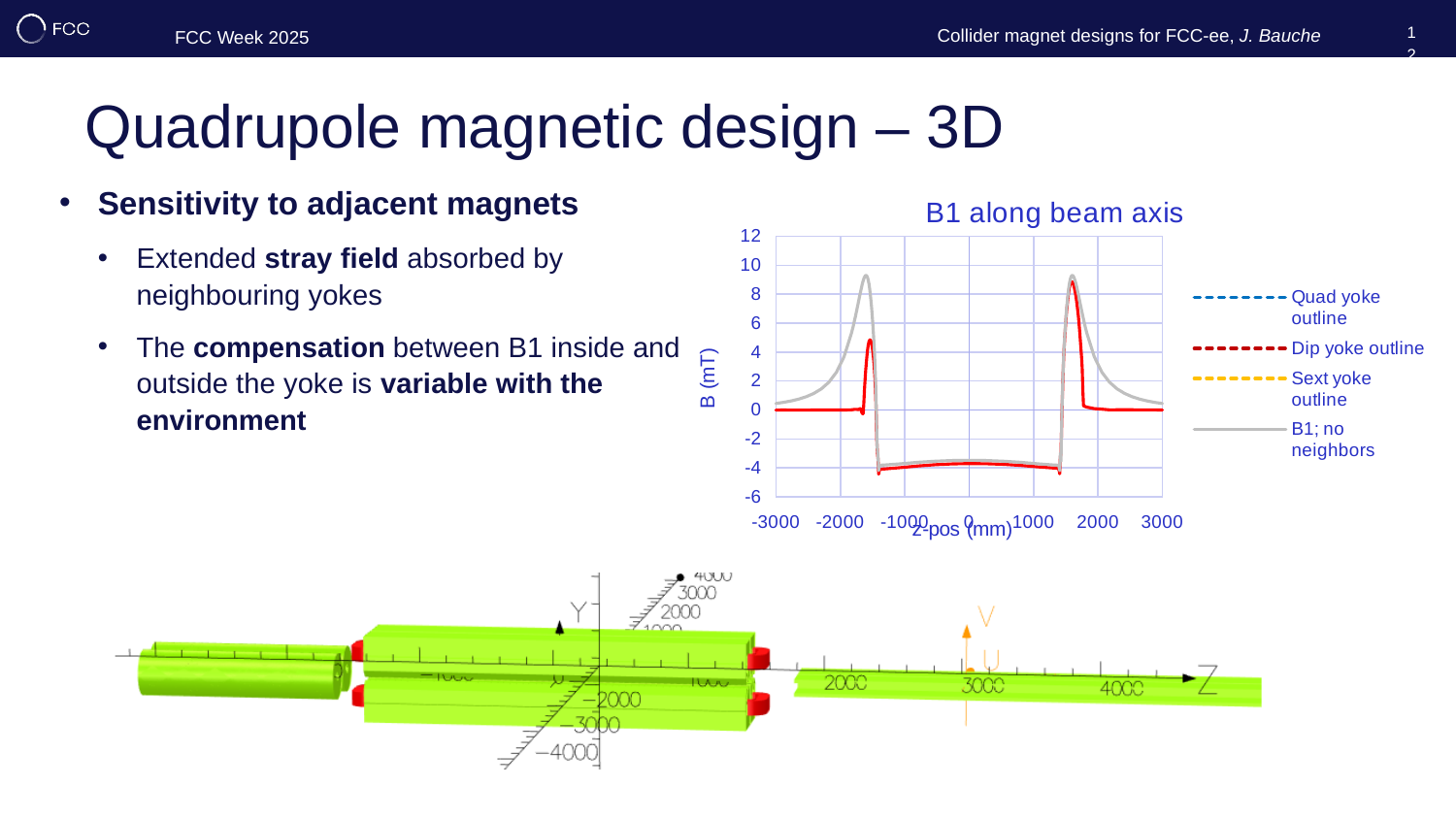
What is the highest value shown on the vertical axis of the "B1 along beam axis" chart? 12 What is the lowest value shown on the vertical axis of the "B1 along beam axis" chart? -6 In the "B1 along beam axis" chart, is the value of the "B1; no neighbors" line at z = 0 mm greater or less than -2 mT? less In the "B1 along beam axis" chart, is the value of the "B1; no neighbors" line at z = -3000 mm greater or less than 2 mT? less In the "B1 along beam axis" chart, is the peak of the red line near z = +1500 mm greater or less than 6 mT? greater What is the label of the vertical axis of the "B1 along beam axis" chart? B (mT) How many entries does the legend of the "B1 along beam axis" chart list? 4 In the "B1 along beam axis" chart, which peak of the red line is higher: the one near z = -1500 mm or the one near z = +1500 mm? the one near z = +1500 mm What is the title of the chart on the slide? B1 along beam axis What kind of chart is "B1 along beam axis"? line chart In the "B1 along beam axis" chart, which is higher near z = -1500 mm: the peak of the grey "B1; no neighbors" line or the peak of the red line? the grey "B1; no neighbors" line